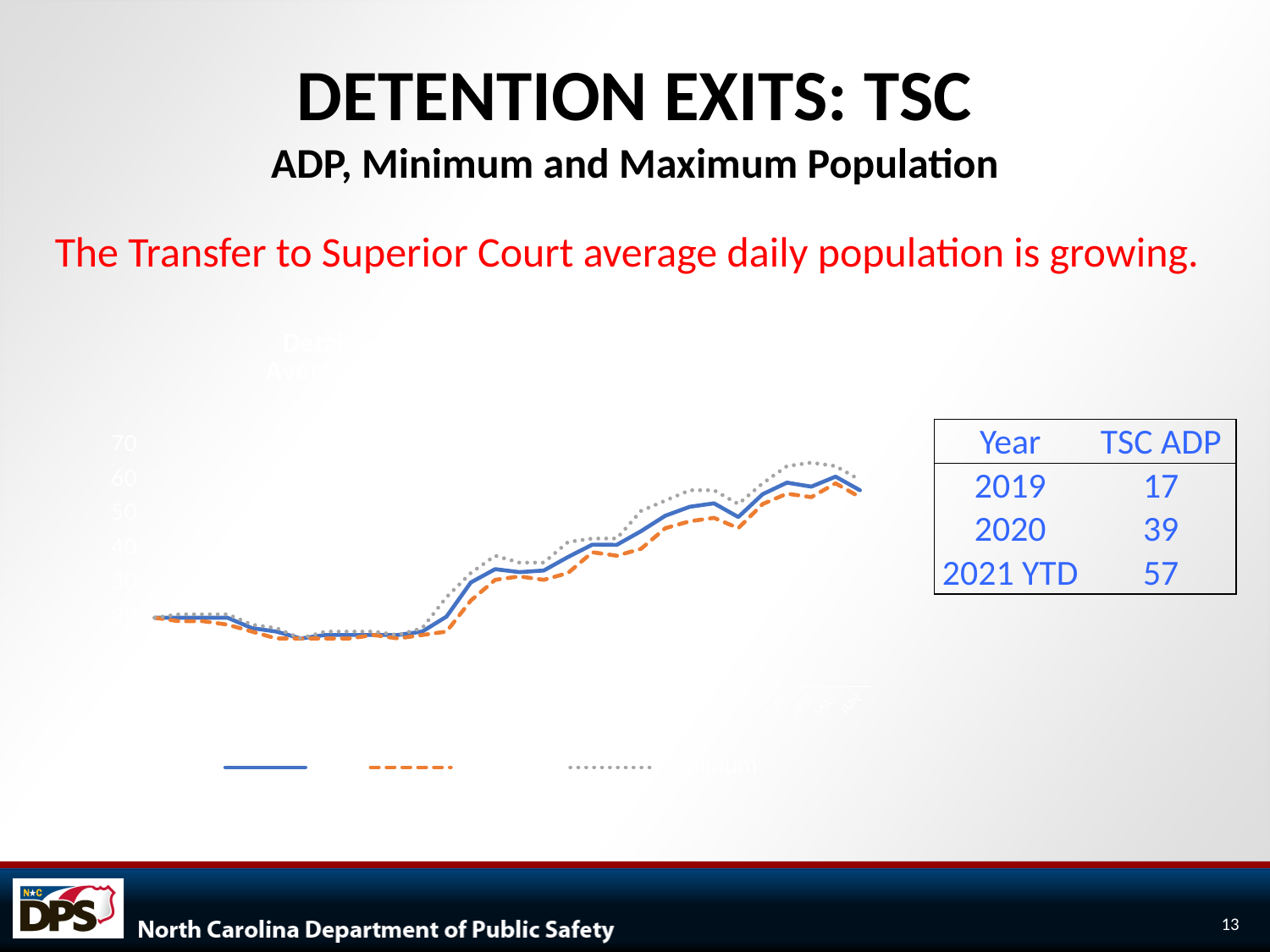
Which of the three lines sits lowest across most of the chart? dashed orange line Which line style is used for the series labelled Maximum in the legend? dotted gray Do the values in the chart generally rise or fall from left to right along the x axis? rise In the table next to the chart, what is the TSC ADP for 2020? 39 Is the value of the solid blue line at the left end of the chart greater or less than 30? less Which of the three lines sits highest across most of the chart? dotted gray line Is the highest point of the dotted gray line greater or less than 60? greater How many series does the chart's legend list? 3 Is the lowest point of the dashed orange line greater or less than 30? less In the table next to the chart, what is the TSC ADP for 2021 YTD? 57 At the right end of the chart, which line is higher: the dotted gray line or the dashed orange line? dotted gray line What kind of chart is shown on the slide? line chart